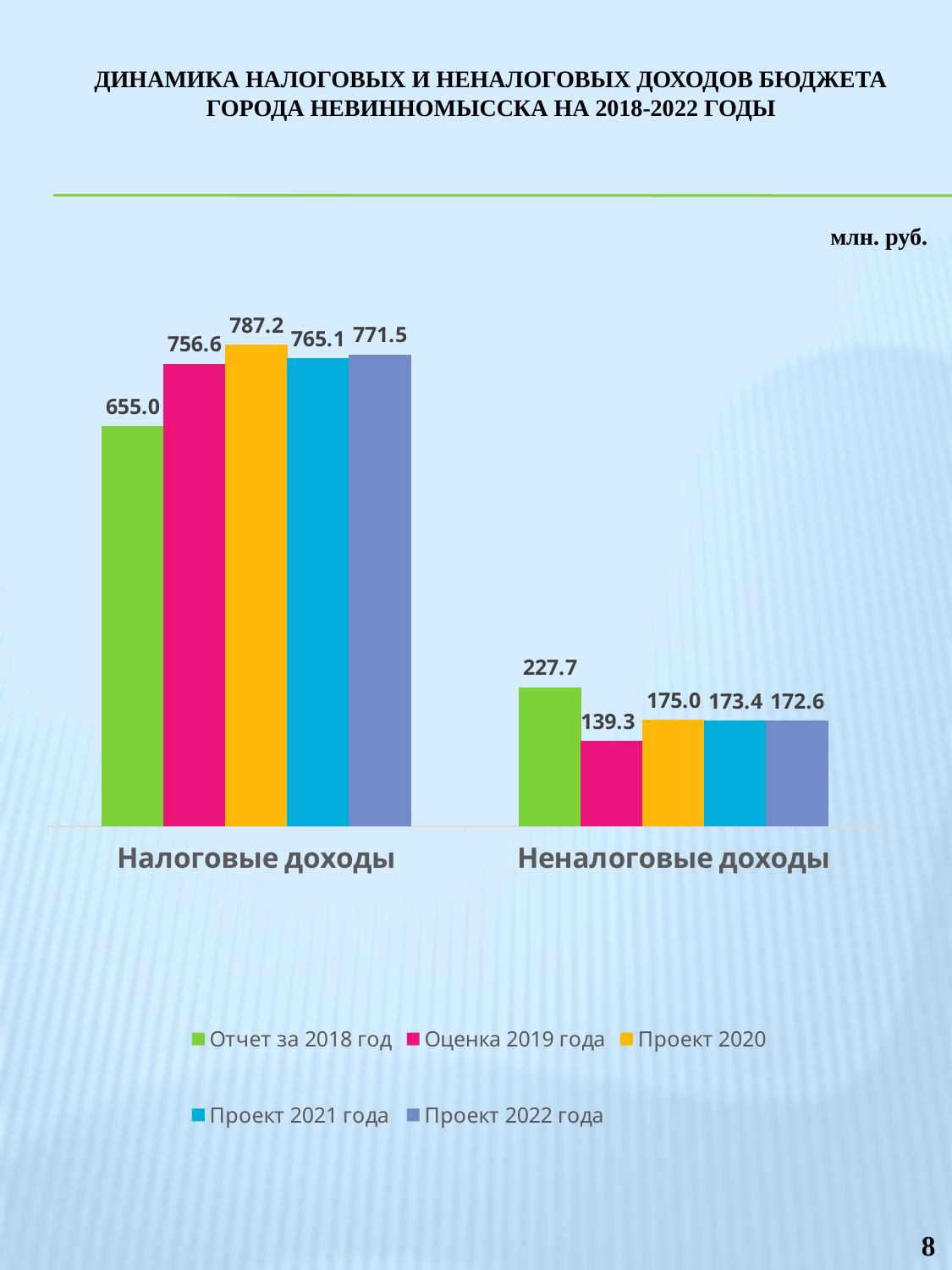
Which series has the highest value for Налоговые доходы? Проект 2020 What kind of chart is shown on the slide? Bar chart Which series has the lowest value for Неналоговые доходы? Оценка 2019 года What is the value for Налоговые доходы in the Отчет за 2018 год series? 655.0 What unit of measurement is indicated for the chart values? млн. руб. How many series does the legend list? 5 What is the difference between the Проект 2020 and Отчет за 2018 год values for Налоговые доходы? 132.2 What is the difference between the Отчет за 2018 год and Оценка 2019 года values for Неналоговые доходы? 88.4 Which is larger for Неналоговые доходы: the Проект 2020 value or the Проект 2022 года value? Проект 2020 What is the value for Неналоговые доходы in the Оценка 2019 года series? 139.3 How many categories are shown on the x axis? 2 What is the value for Налоговые доходы in the Проект 2022 года series? 771.5